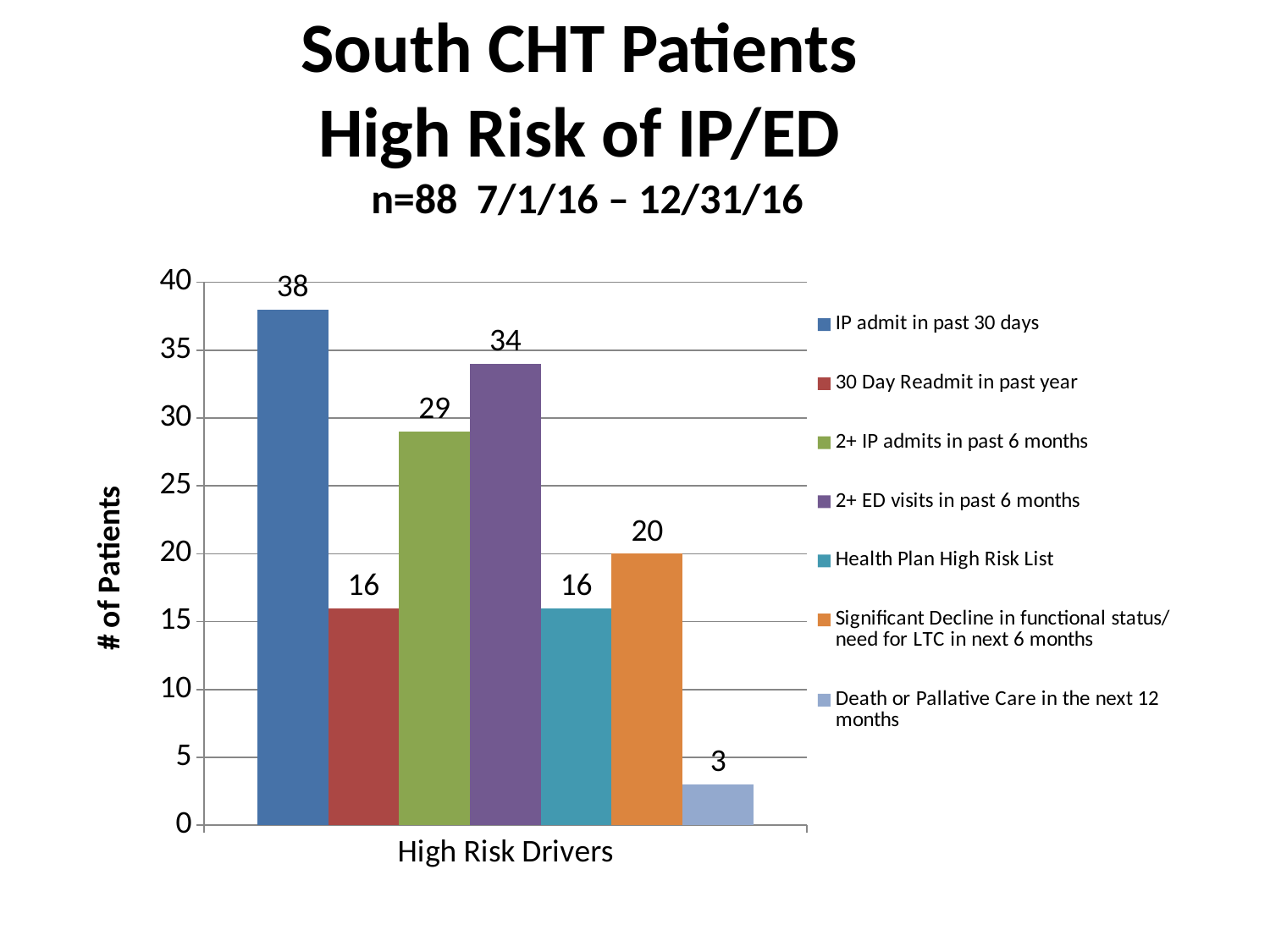
How many patients had an IP admit in the past 30 days? 38 What is the difference between the number of patients with 2+ IP admits in past 6 months and those with a 30 Day Readmit in past year? 13 What is the value for 2+ ED visits in past 6 months? 34 What is the label on the vertical axis? # of Patients Which high risk driver has the highest number of patients? IP admit in past 30 days Which is larger: 2+ ED visits in past 6 months or Significant Decline in functional status/need for LTC in next 6 months? 2+ ED visits in past 6 months What is the difference between the highest and lowest bar values? 35 What is the label on the horizontal axis? High Risk Drivers Which high risk driver has the lowest number of patients? Death or Pallative Care in the next 12 months How many series does the legend list? 7 How many patients are on the Health Plan High Risk List? 16 What kind of chart is shown on the slide? Bar chart